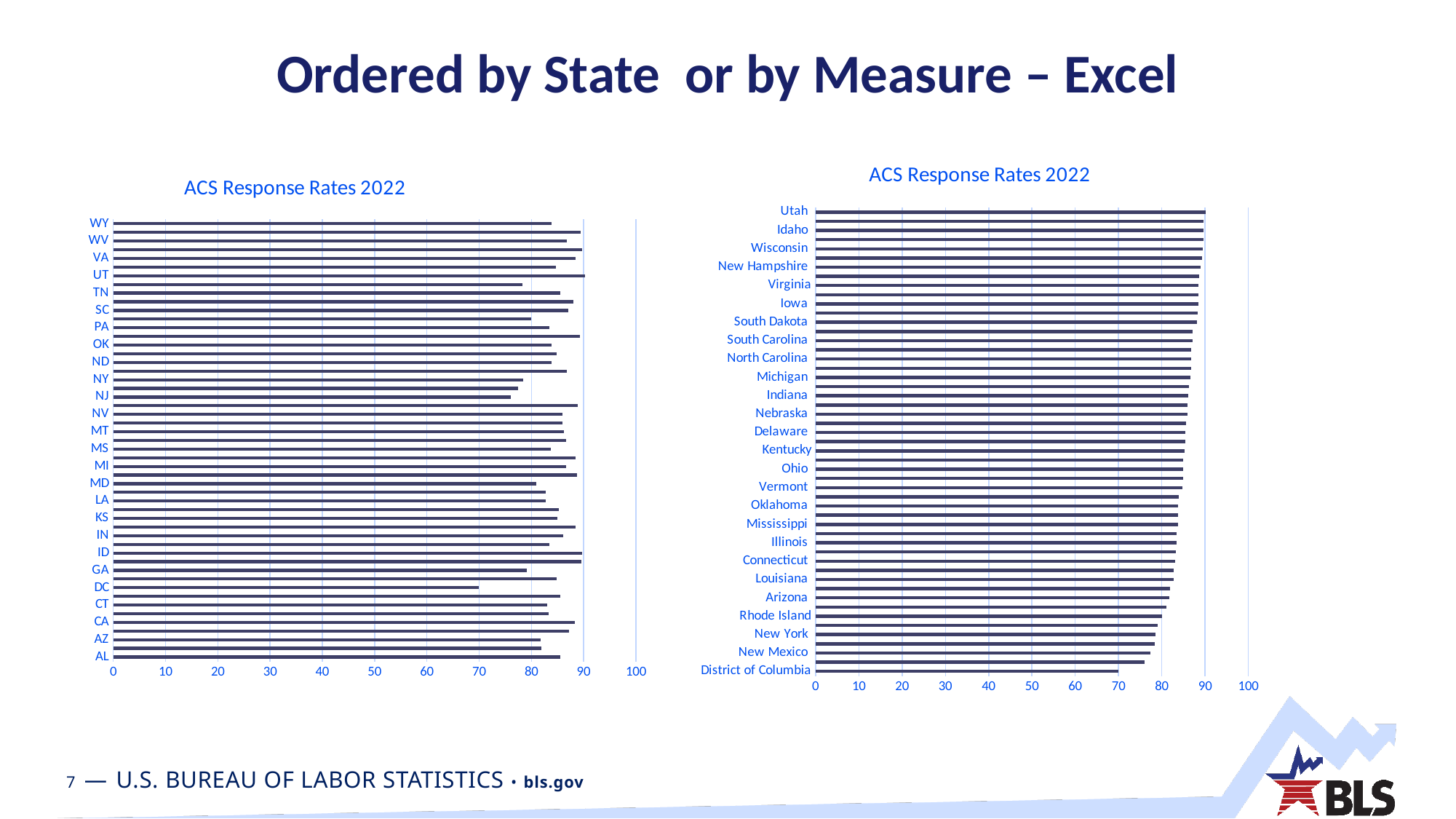
What is the title of the right chart? ACS Response Rates 2022 In the left chart, is the value for WY greater or less than 80? greater In the right chart, is the value for Utah greater or less than 80? greater In the left chart, is the value for NJ greater or less than 80? less In the right chart (ordered by measure), which area has the lowest response rate? District of Columbia In the right chart (ordered by measure), which state has the highest response rate? Utah In the right chart, which is larger, the value for Utah or the value for District of Columbia? Utah What kind of chart is the left chart on the slide? bar chart In the left chart (ordered by state), which area has the shortest bar? DC In the right chart, do the bar values increase or decrease going from the top (Utah) to the bottom (District of Columbia)? decrease